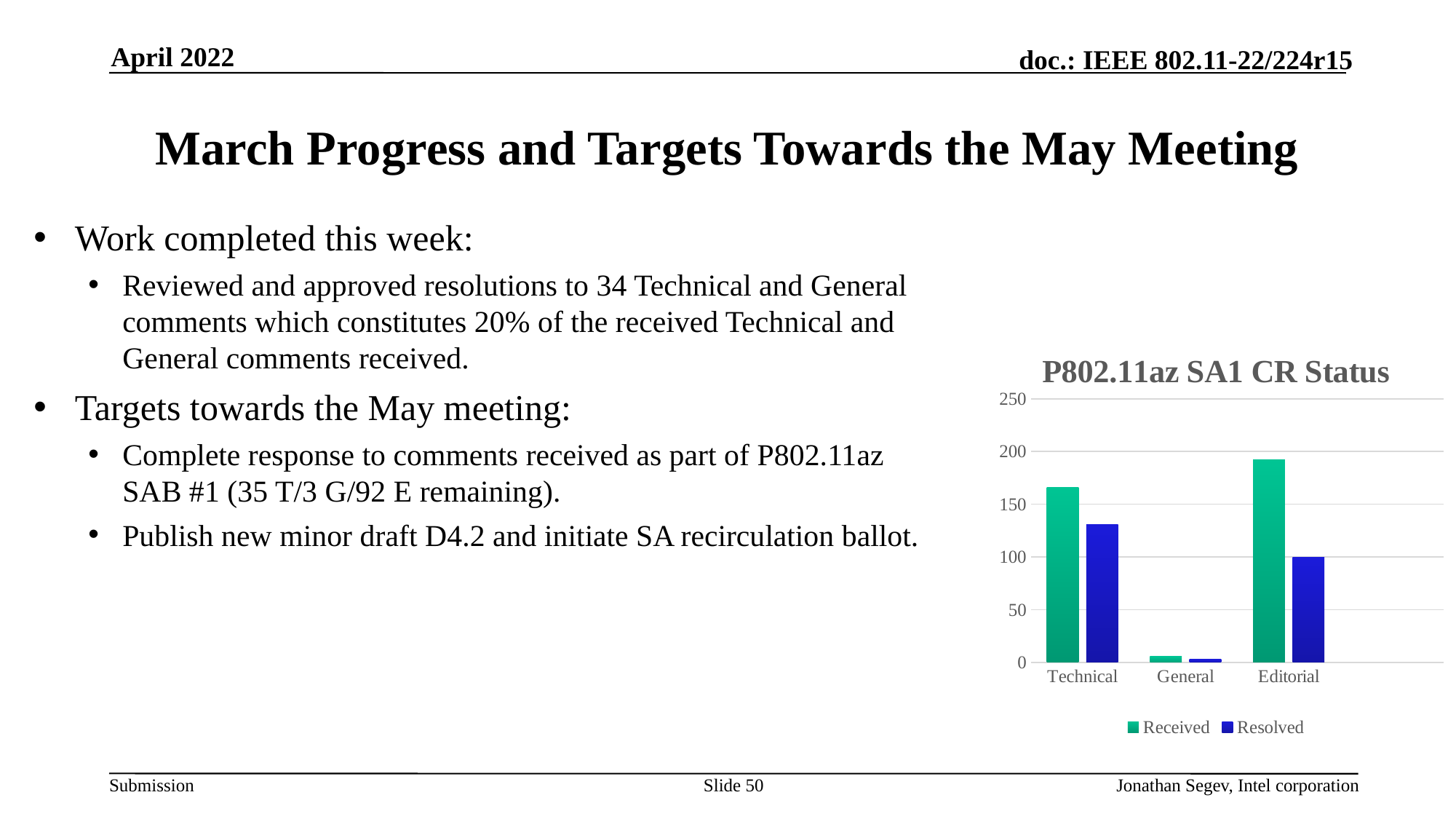
How many categories are shown on the x axis of the chart? 3 Which category has the lowest Received value? General Is the Resolved value for Technical greater or less than 150? less What is the title of the chart? P802.11az SA1 CR Status Is the Received value for Technical greater or less than 150? greater Which category has the highest Resolved value? Technical Which category has the highest Received value? Editorial Which series is shown in dark blue in the chart legend? Resolved What type of chart is shown on the slide? bar chart Is the Received value for Editorial greater or less than 200? less Which is larger: the Resolved value for Technical or the Resolved value for Editorial? Technical How many series does the chart legend list? 2